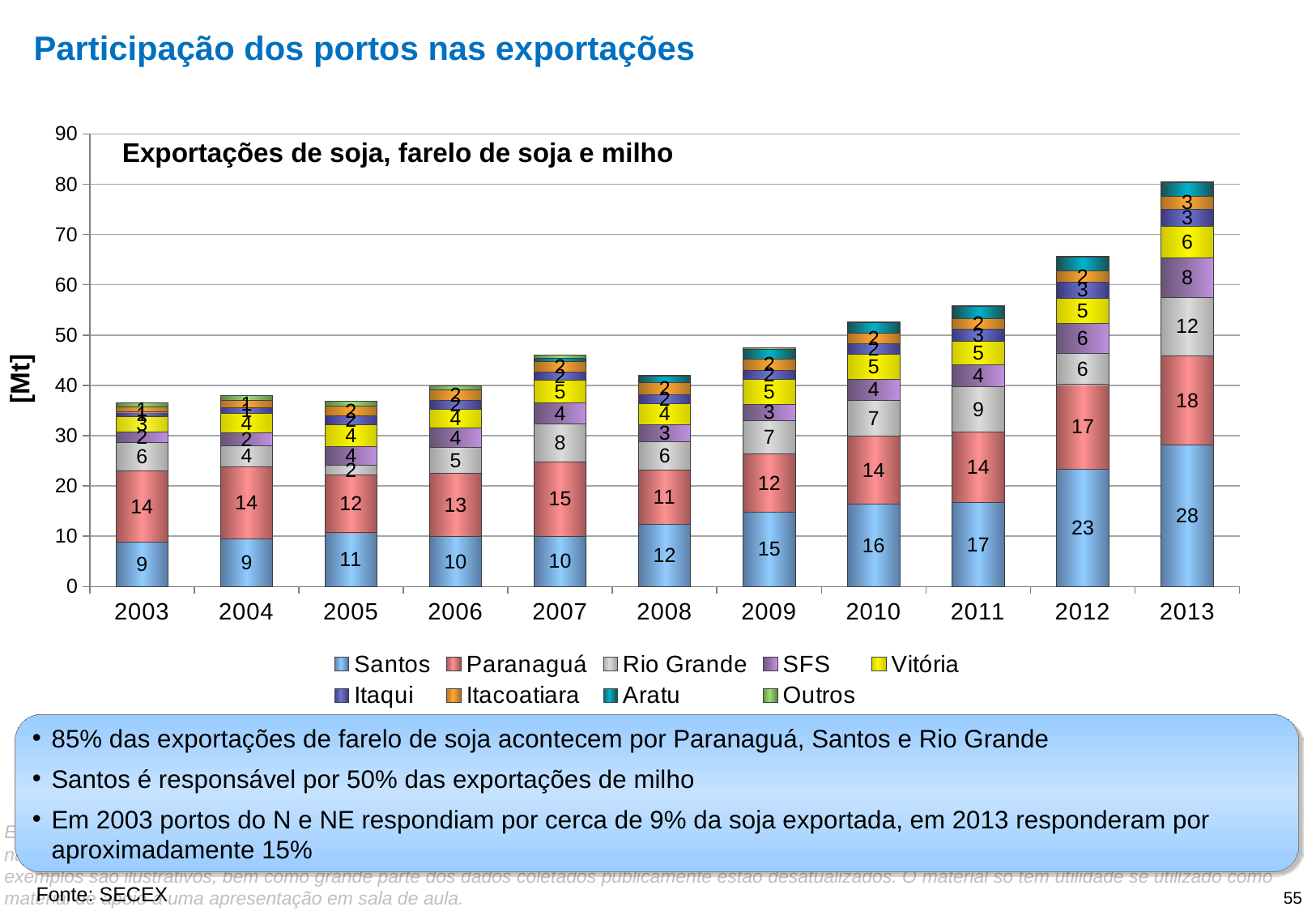
What is the value for Santos in 2013? 28 In which year is the Paranaguá value lowest? 2008 What is the difference between the Santos value in 2013 and in 2003? 19 In 2003, which is larger: the Santos value or the Paranaguá value? Paranaguá What is the value for Rio Grande in 2011? 9 What is the value for Paranaguá in 2007? 15 What is the value for SFS in 2013? 8 How many years are shown on the x axis of the chart? 11 In which year is the Santos value highest? 2013 Is the total height of the 2012 bar greater or less than 60? greater What type of chart is shown on the slide? Stacked bar chart How many series does the legend list? 9